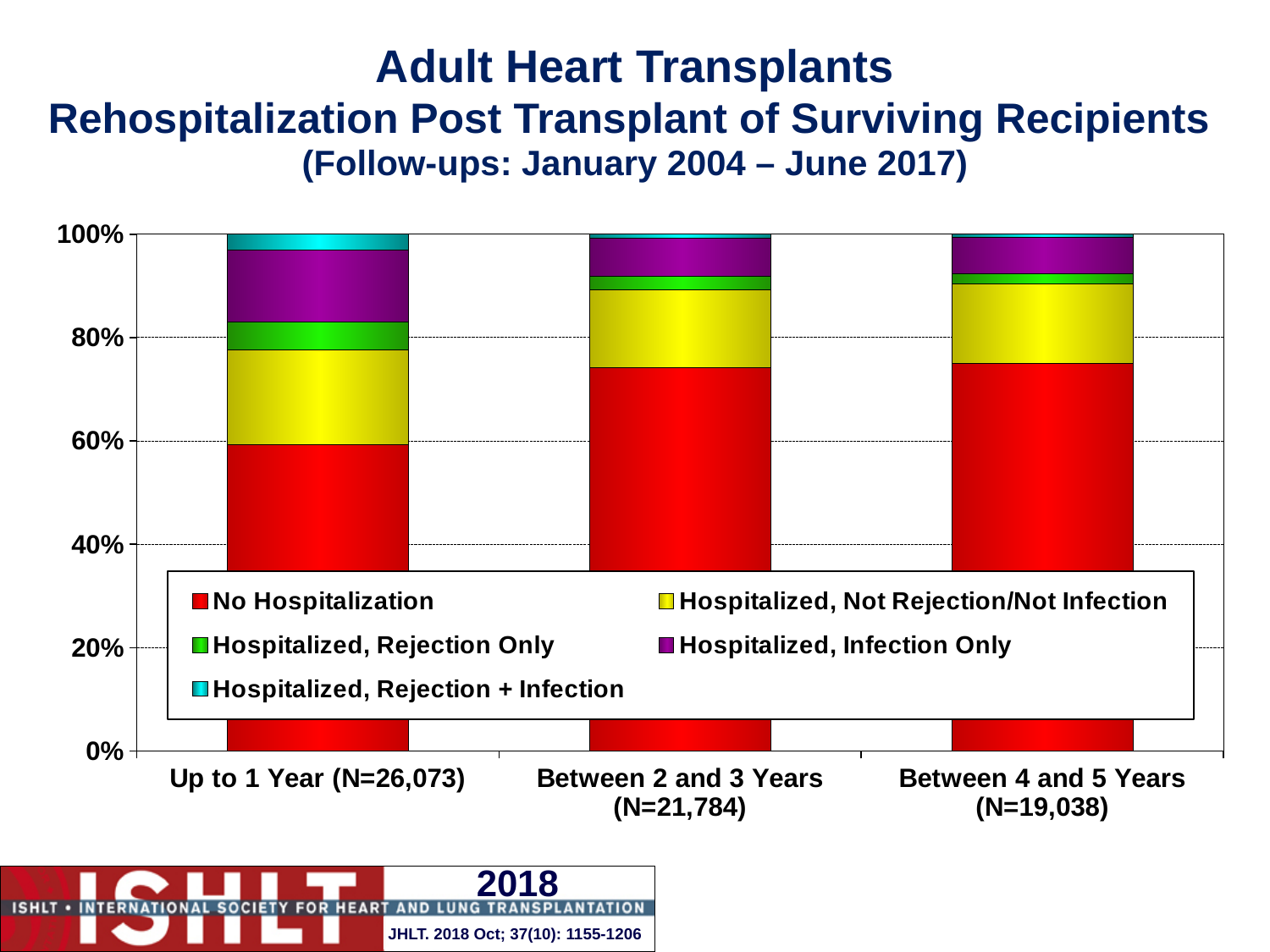
Is the No Hospitalization share for Up to 1 Year greater or less than 40%? greater Which follow-up category has the largest Hospitalized, Infection Only segment? Up to 1 Year (N=26,073) What is the total height of each stacked bar? 100% How many follow-up time categories are plotted along the x axis? 3 Is the No Hospitalization share for Between 2 and 3 Years greater or less than 60%? greater Which is larger: the No Hospitalization share for Up to 1 Year or for Between 4 and 5 Years? Between 4 and 5 Years Is the No Hospitalization share for Between 4 and 5 Years greater or less than 60%? greater What is the N shown for the Between 2 and 3 Years category? N=21,784 Which follow-up category has the smallest No Hospitalization segment? Up to 1 Year (N=26,073) How many series does the legend list? 5 What kind of chart is shown on the slide? Stacked bar chart Which colour represents No Hospitalization in the legend? Red